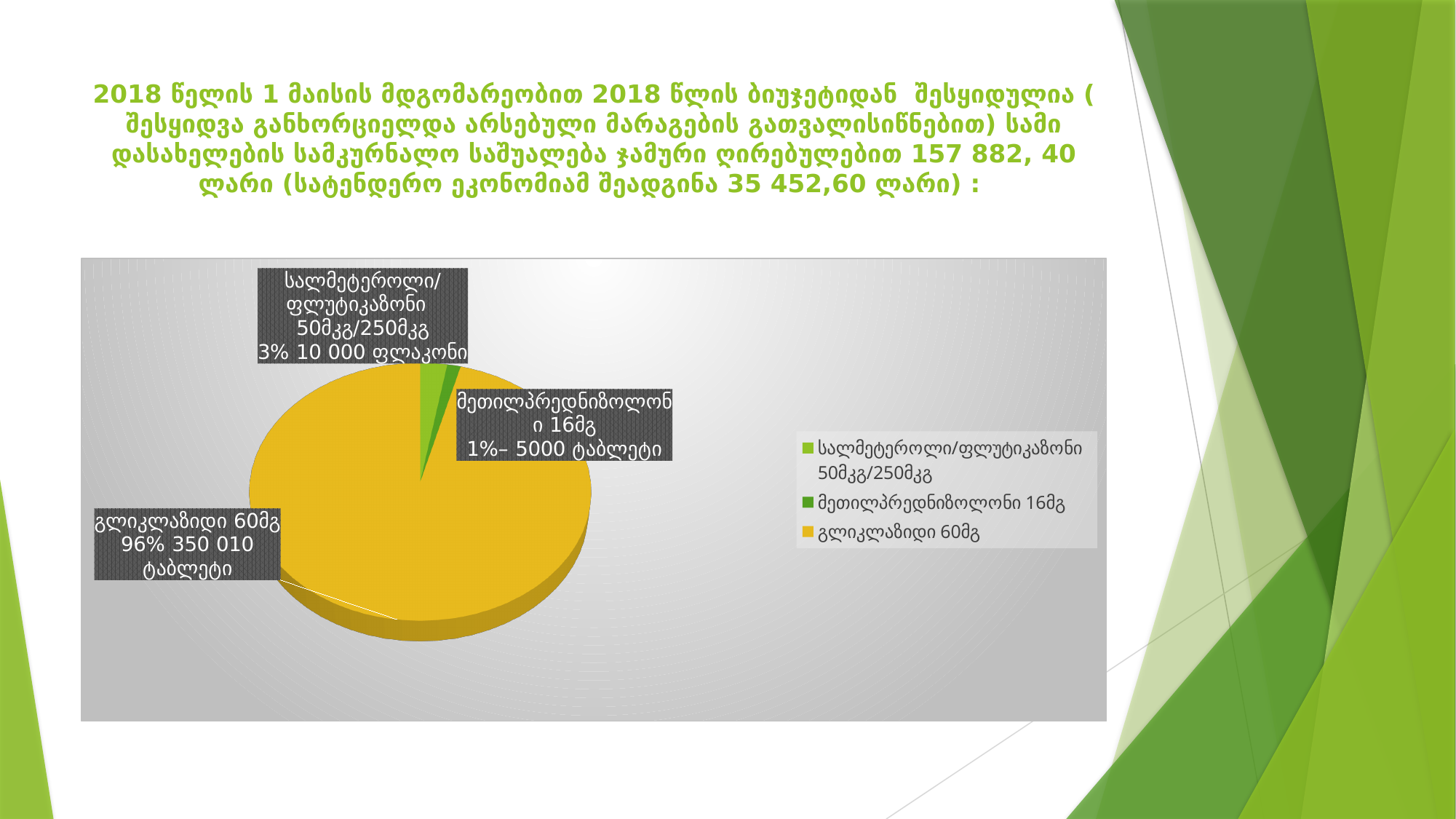
What quantity is shown in the data label for მეთილპრედნიზოლონი 16მგ? 5000 ტაბლეტი Which slice of the pie chart is the largest? გლიკლაზიდი 60მგ What share of the pie does მეთილპრედნიზოლონი 16მგ represent? 1% Which slice of the pie chart is the smallest? მეთილპრედნიზოლონი 16მგ What kind of chart is shown on the slide? pie chart What colour is the slice for გლიკლაზიდი 60მგ in the pie chart? yellow What share of the pie does გლიკლაზიდი 60მგ represent? 96% What quantity is shown in the data label for სალმეტეროლი/ფლუტიკაზონი 50მკგ/250მკგ? 10 000 ფლაკონი What quantity is shown in the data label for გლიკლაზიდი 60მგ? 350 010 ტაბლეტი How many slices does the pie chart have? 3 How many entries does the legend of the pie chart list? 3 What share of the pie does სალმეტეროლი/ფლუტიკაზონი 50მკგ/250მკგ represent? 3%